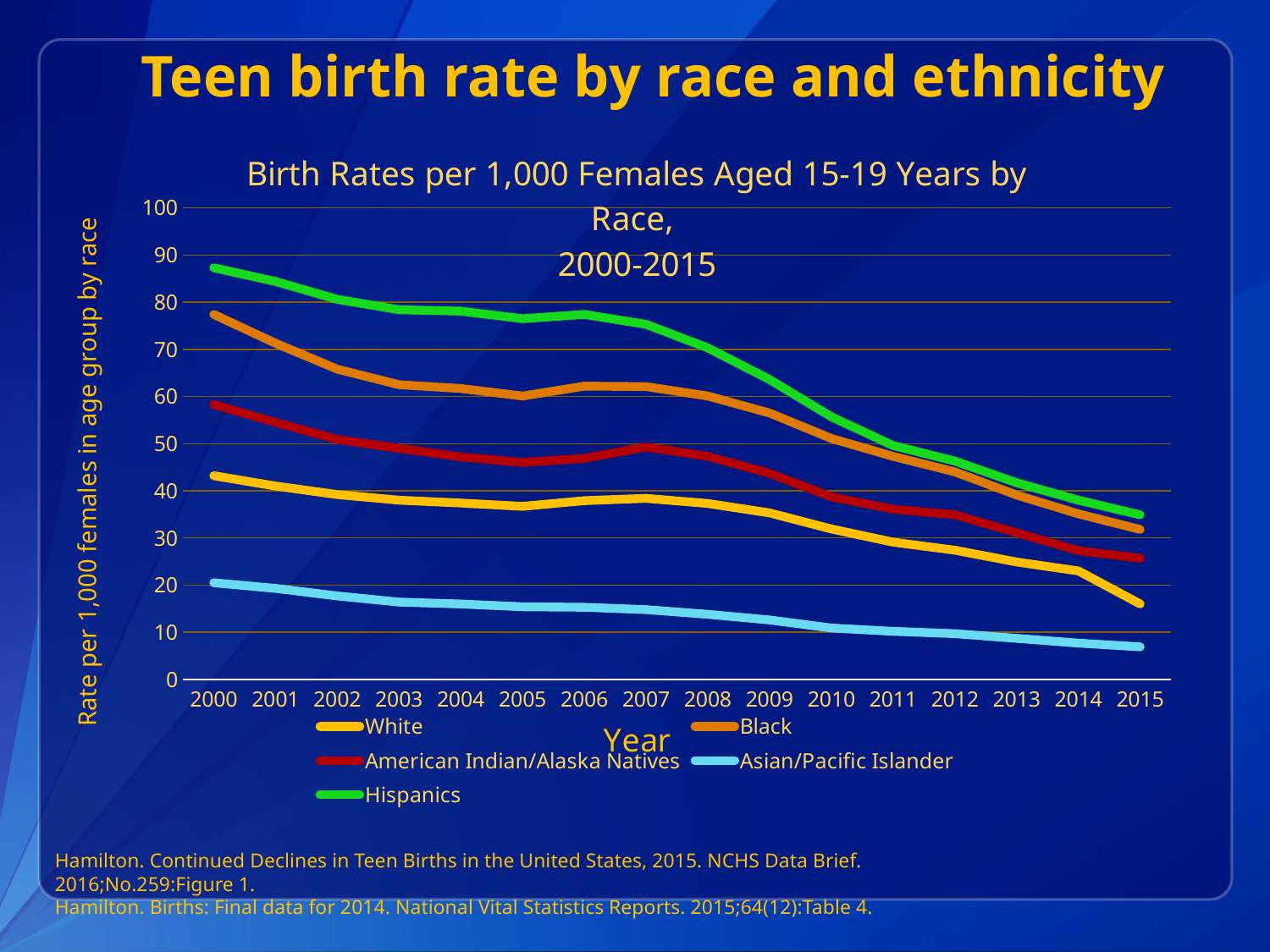
Does the White series rise or fall from 2000 to 2015? Fall In 2015, which is larger: the value for White or for American Indian/Alaska Natives? American Indian/Alaska Natives What is the label of the x axis? Year What kind of chart is shown on the slide? Line chart Is the value for Black in 2015 greater or less than 40? less How many series does the legend list? 5 Which series has the highest value in 2000? Hispanics In 2010, which is larger: the value for Black or for American Indian/Alaska Natives? Black Is the value for Hispanics in 2000 greater or less than 80? greater How many years are shown along the x axis? 16 Which series has the lowest value in 2015? Asian/Pacific Islander Is the value for Asian/Pacific Islander in 2000 greater or less than 30? less